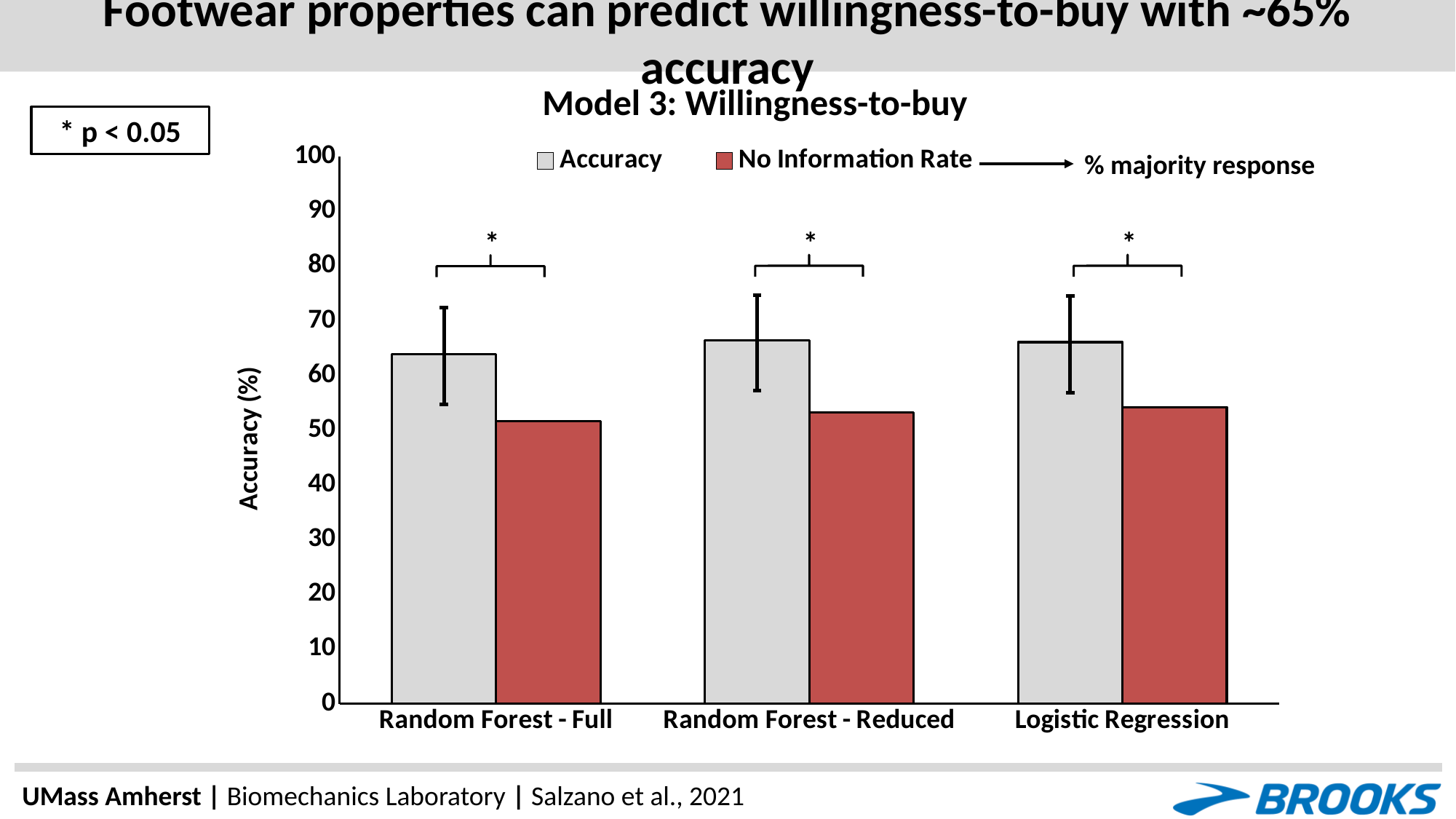
For Random Forest - Full, which is larger: Accuracy or No Information Rate? Accuracy How many model categories are shown on the x axis? 3 Is the No Information Rate value for Random Forest - Full greater or less than 50? greater What kind of chart is shown on the slide? bar chart For Random Forest - Reduced, which is larger: Accuracy or No Information Rate? Accuracy How many series does the legend list? 2 What is the title of the chart? Model 3: Willingness-to-buy Is the Accuracy value for Random Forest - Reduced greater or less than 70? less Is the No Information Rate value for Logistic Regression greater or less than 60? less What is the label of the y axis? Accuracy (%) For Logistic Regression, which is larger: Accuracy or No Information Rate? Accuracy